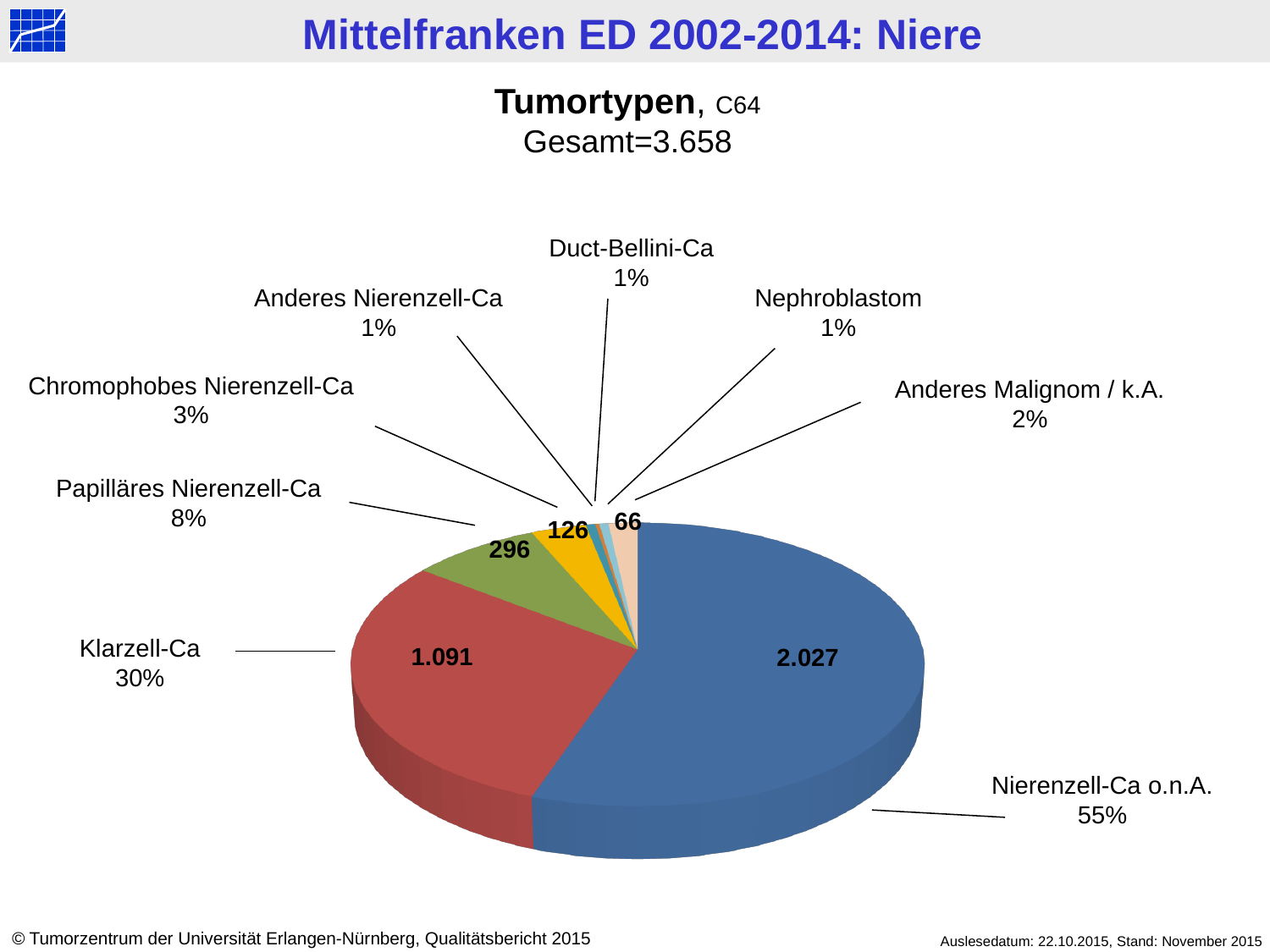
What percentage is shown for Chromophobes Nierenzell-Ca? 3% What is the number of cases labelled on the Klarzell-Ca slice? 1.091 How many tumour type categories are shown in the pie chart? 8 What share of the pie does Nierenzell-Ca o.n.A. represent? 55% What percentage is shown for Anderes Malignom / k.A.? 2% What is the difference in cases between Nierenzell-Ca o.n.A. (2.027) and Klarzell-Ca (1.091)? 936 What share of the pie does Klarzell-Ca represent? 30% What is the number of cases labelled on the Nierenzell-Ca o.n.A. slice? 2.027 Which has the larger share, Klarzell-Ca or Papilläres Nierenzell-Ca? Klarzell-Ca Which tumour type has the largest slice of the pie? Nierenzell-Ca o.n.A. What kind of chart is shown on the slide? Pie chart What percentage is shown for Papilläres Nierenzell-Ca? 8%